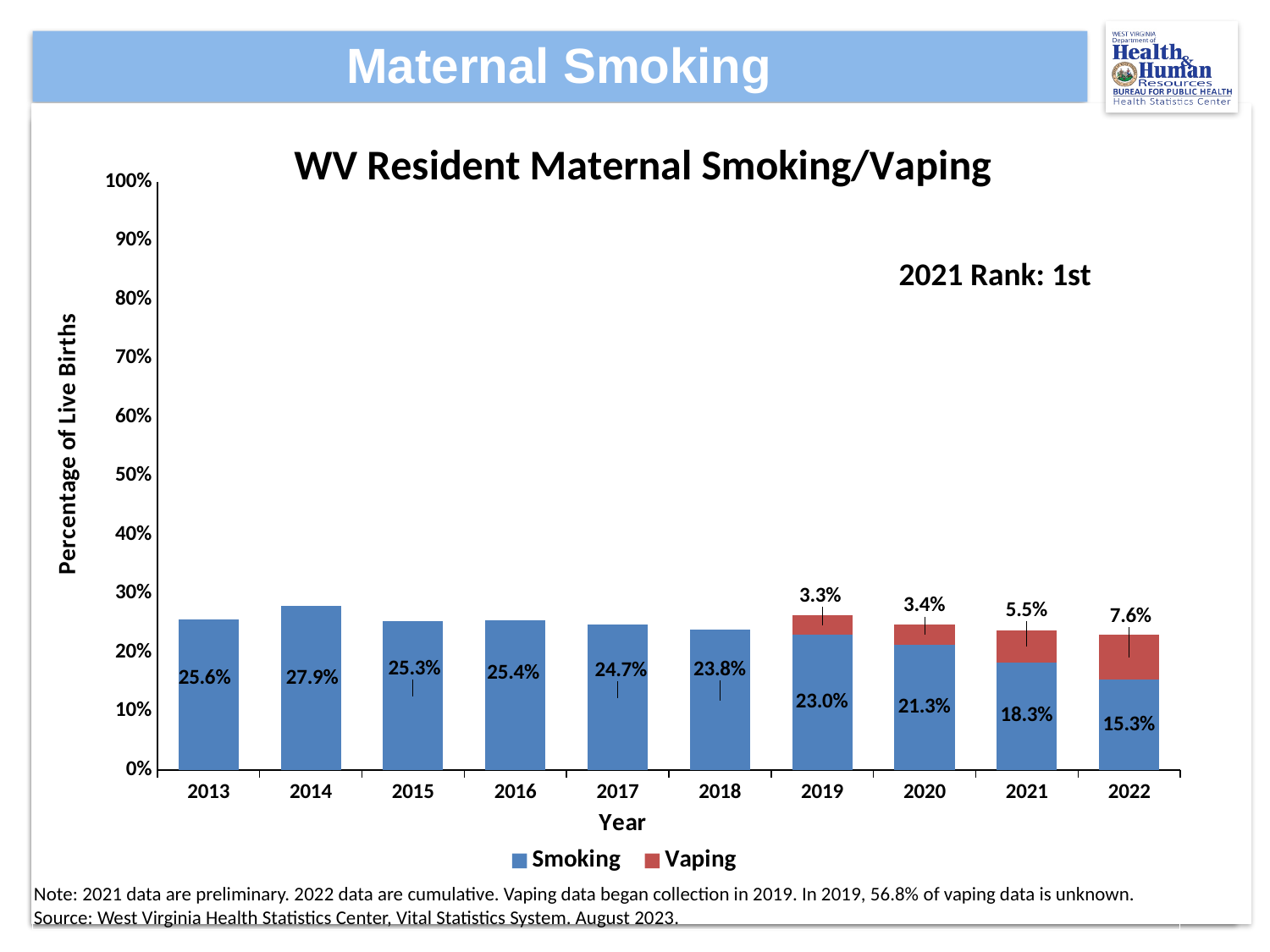
How many series does the legend list? 2 What kind of chart is shown on the slide? Stacked bar chart Which year has the lowest Smoking value? 2022 Do the Smoking values rise or fall from 2014 to 2022? Fall How many years are shown on the x axis? 10 What is the Vaping value for 2022? 7.6% Which year has the highest Smoking value? 2014 What is the total of the stacked bar for 2022 (Smoking plus Vaping)? 22.9% What is the difference between the Smoking values for 2013 and 2022? 10.3% What is the Smoking value for 2021? 18.3% Which is larger, the Vaping value for 2020 or the Vaping value for 2021? 2021 What is the Smoking value for 2014? 27.9%